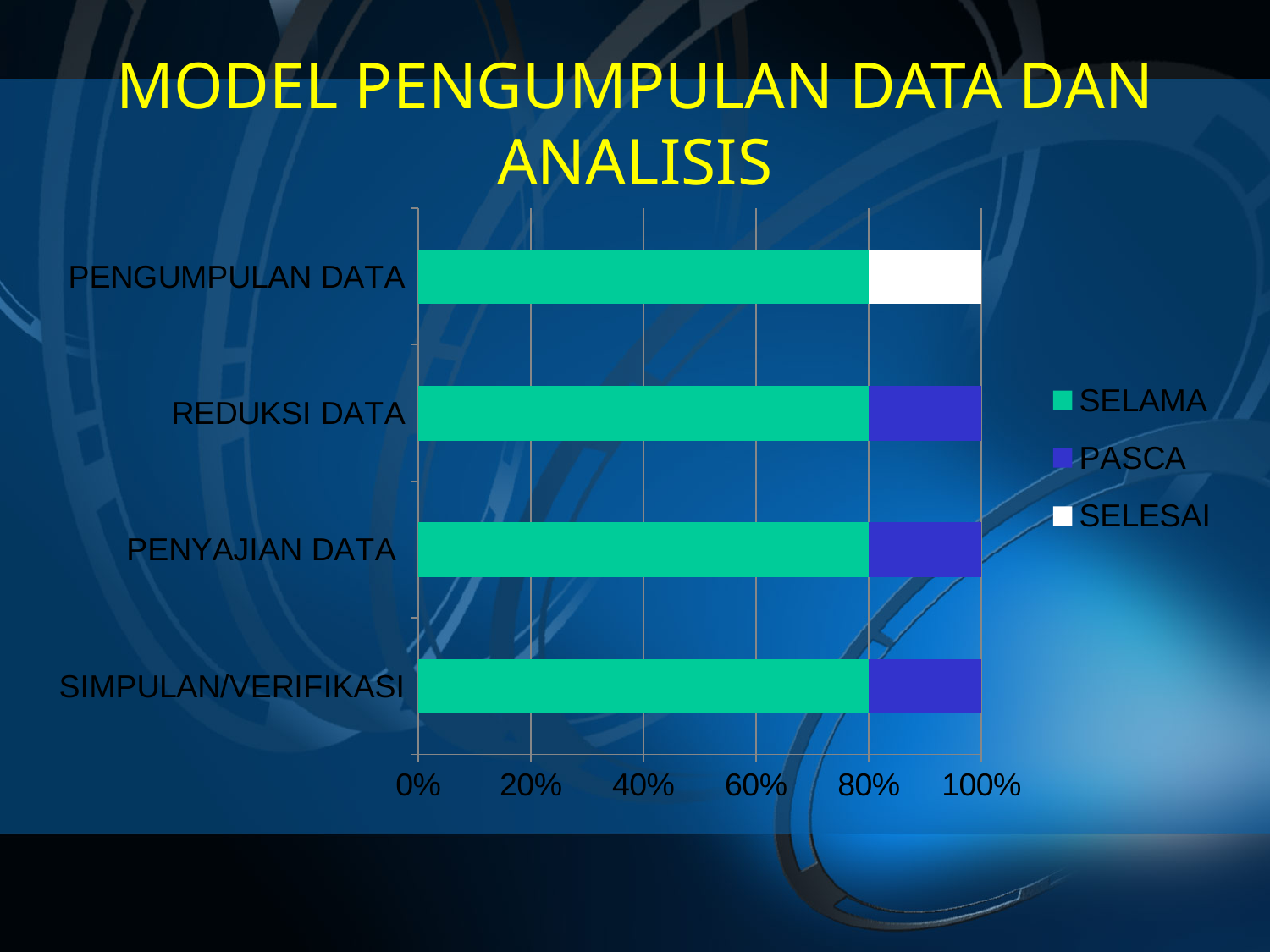
What is the highest value shown on the x axis? 100% How many categories are plotted on the chart? 4 Is the SELAMA value for SIMPULAN/VERIFIKASI greater or less than 60%? greater Is the PASCA value for PENYAJIAN DATA greater or less than 40%? less What kind of chart is shown on the slide? bar chart What are the series names listed in the legend? SELAMA, PASCA, SELESAI How many series does the legend list? 3 Which category is the only one with a SELESAI segment? PENGUMPULAN DATA What is the SELAMA value for PENGUMPULAN DATA? 80% What is the total of the stacked bar for PENGUMPULAN DATA? 100% What is the SELAMA value for REDUKSI DATA? 80%